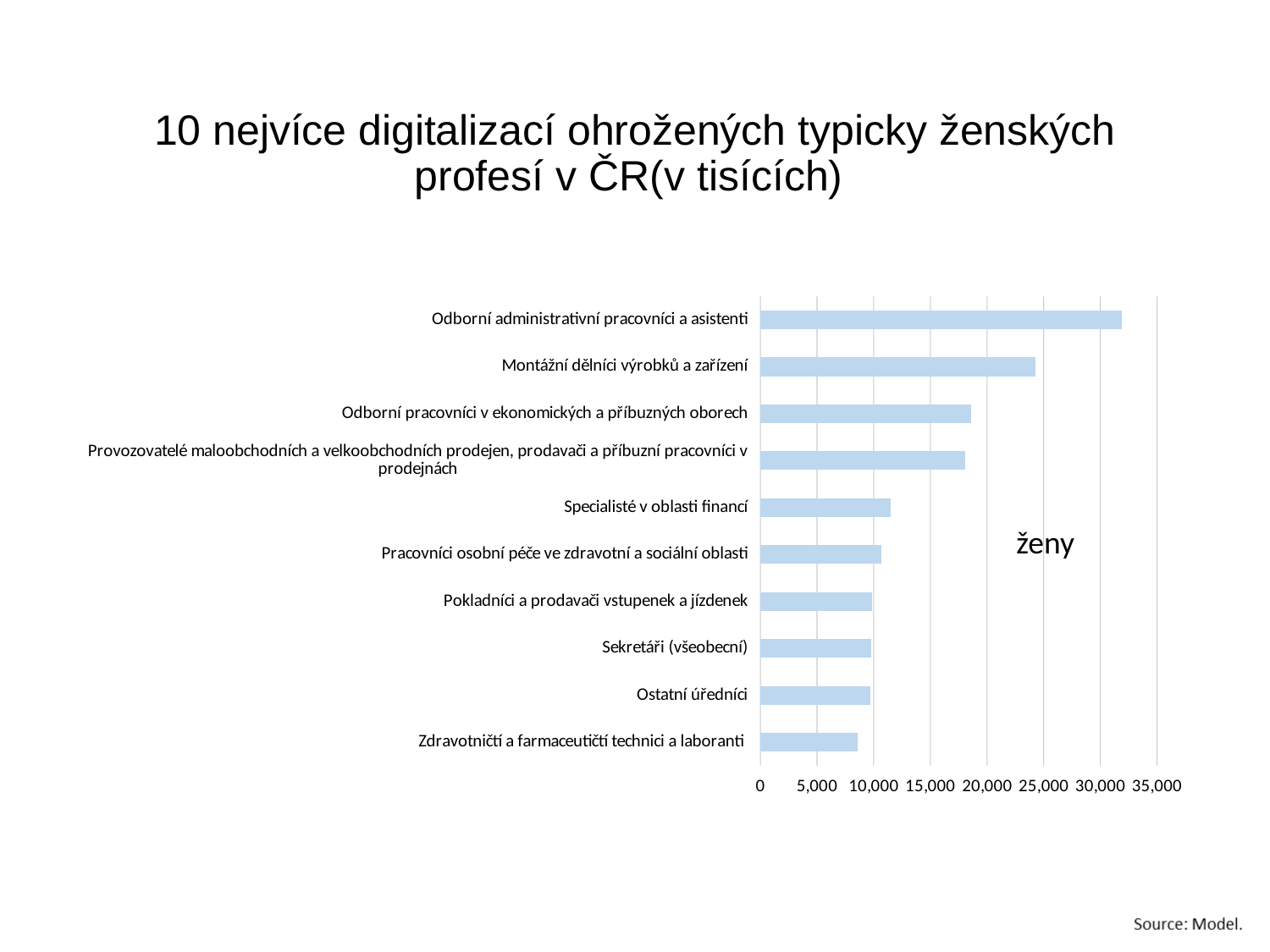
How many professions (categories) are plotted in the chart? 10 Which has the larger value: Montážní dělníci výrobků a zařízení or Odborní pracovníci v ekonomických a příbuzných oborech? Montážní dělníci výrobků a zařízení Is the value for Odborní administrativní pracovníci a asistenti greater or less than 30,000? greater Which profession has the highest value in the chart? Odborní administrativní pracovníci a asistenti Is the value for Montážní dělníci výrobků a zařízení greater or less than 25,000? less Is the value for Specialisté v oblasti financí greater or less than 10,000? greater What kind of chart is shown on the slide? bar chart Which profession has the lowest value in the chart? Zdravotničtí a farmaceutičtí technici a laboranti What is the title of the chart on the slide? 10 nejvíce digitalizací ohrožených typicky ženských profesí v ČR(v tisících)